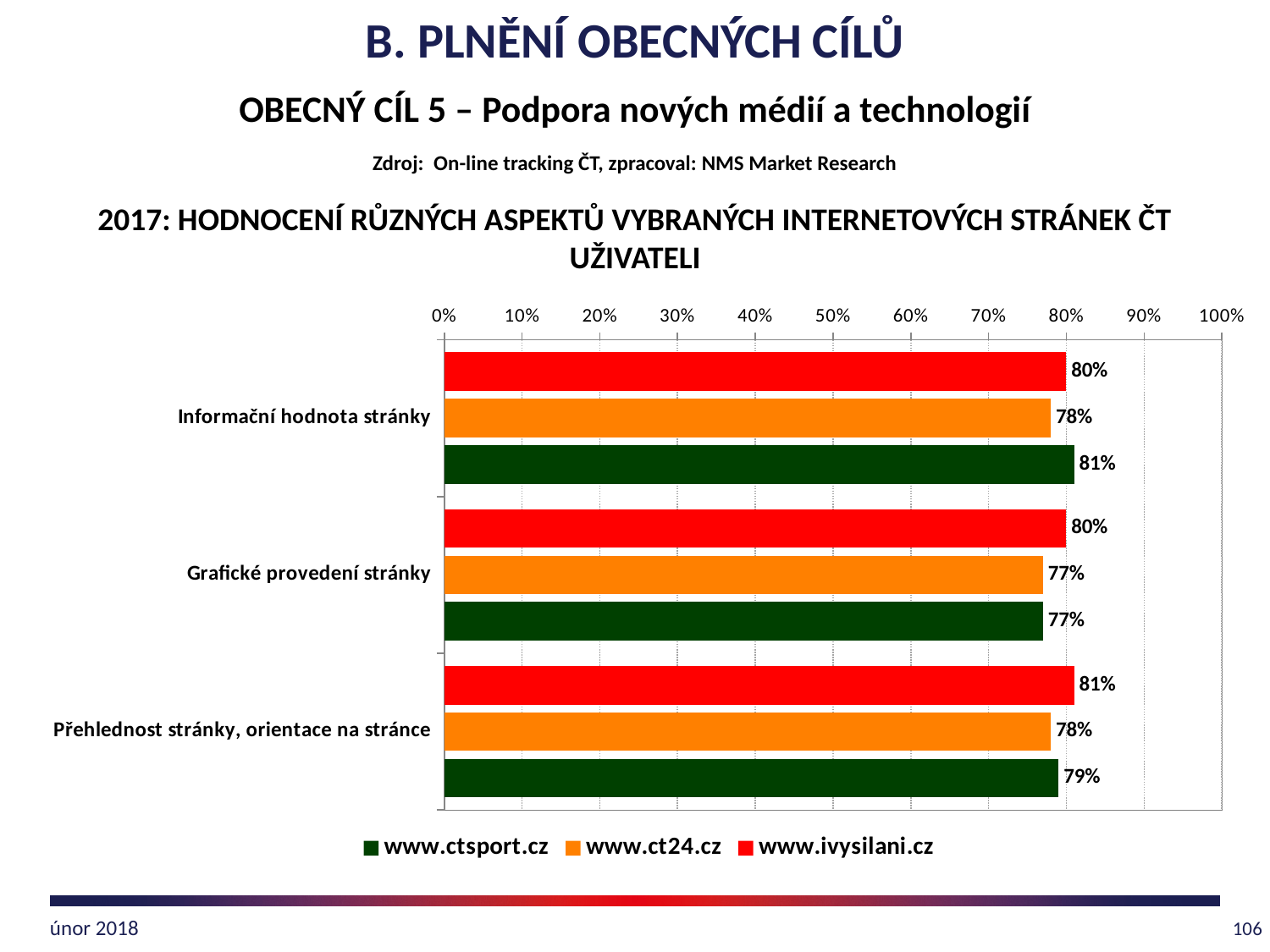
What is the value for www.ct24.cz for 'Přehlednost stránky, orientace na stránce'? 78% How many categories (aspects) are shown on the chart? 3 For 'Přehlednost stránky, orientace na stránce', which is larger: www.ivysilani.cz or www.ctsport.cz? www.ivysilani.cz What is the value for www.ct24.cz for 'Grafické provedení stránky'? 77% What is the value for www.ivysilani.cz for 'Přehlednost stránky, orientace na stránce'? 81% Which website has the lowest value for 'Přehlednost stránky, orientace na stránce'? www.ct24.cz What is the value for www.ctsport.cz for 'Informační hodnota stránky'? 81% Which colour represents www.ct24.cz in the chart? orange What kind of chart is shown on the slide? bar chart Which website has the highest value for 'Informační hodnota stránky'? www.ctsport.cz How many series does the legend list? 3 What is the difference between www.ivysilani.cz and www.ct24.cz for 'Grafické provedení stránky'? 3%